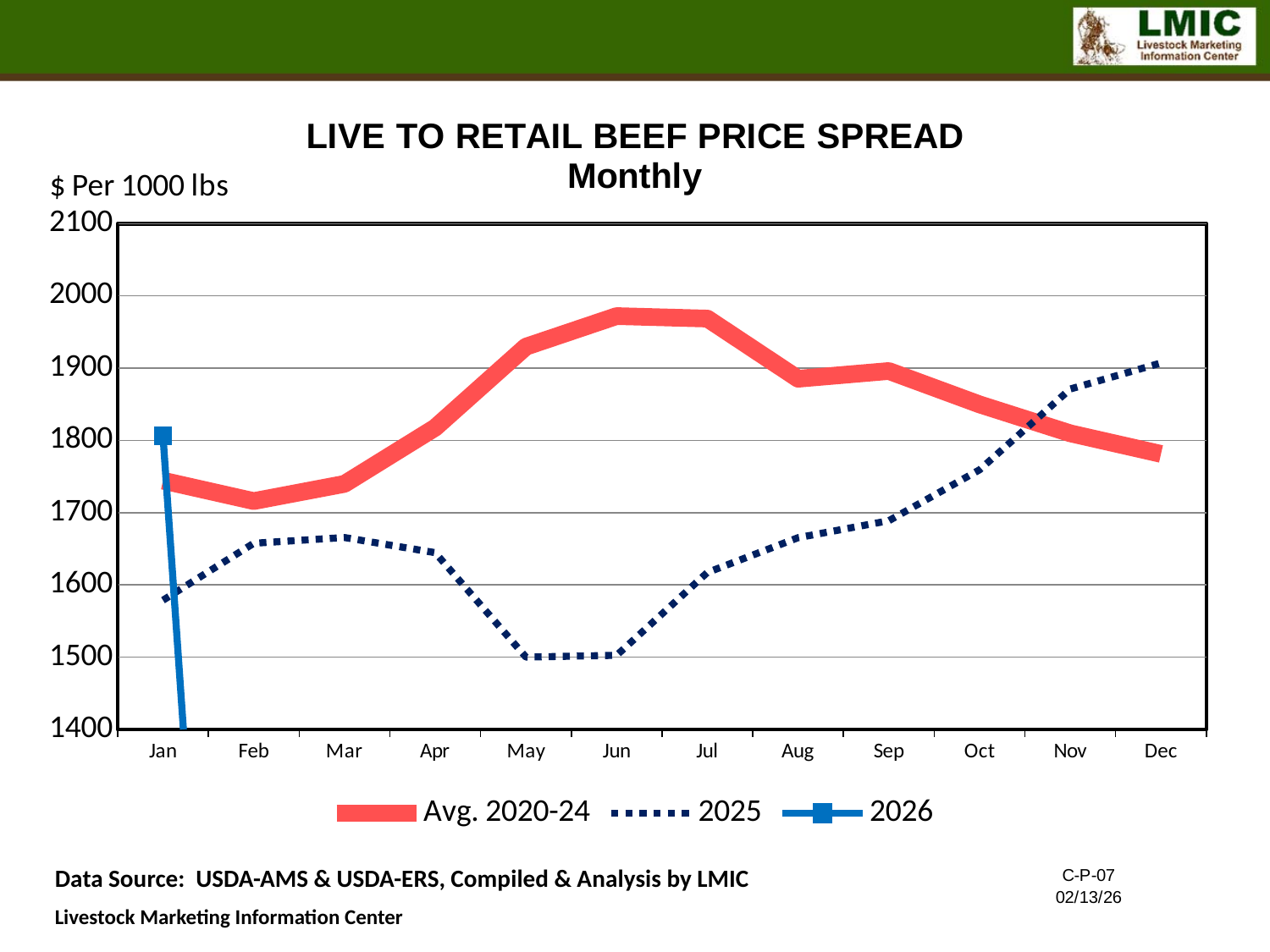
How many series does the legend list? 3 Is the value for Avg. 2020-24 in Dec greater or less than 1800? less In which month is the 2025 series highest? Dec In Jun, which series has the larger value, Avg. 2020-24 or 2025? Avg. 2020-24 Is the value for 2025 in Jan greater or less than 1600? less Is the value for Avg. 2020-24 in Jun greater or less than 1900? greater Which series does the dotted dark blue line represent? 2025 How many months are shown on the x axis? 12 What kind of chart is shown on the slide? line chart In which month is the Avg. 2020-24 series lowest? Feb What unit is shown on the y axis label? $ Per 1000 lbs Does the 2025 series rise or fall from Jul to Dec? rise